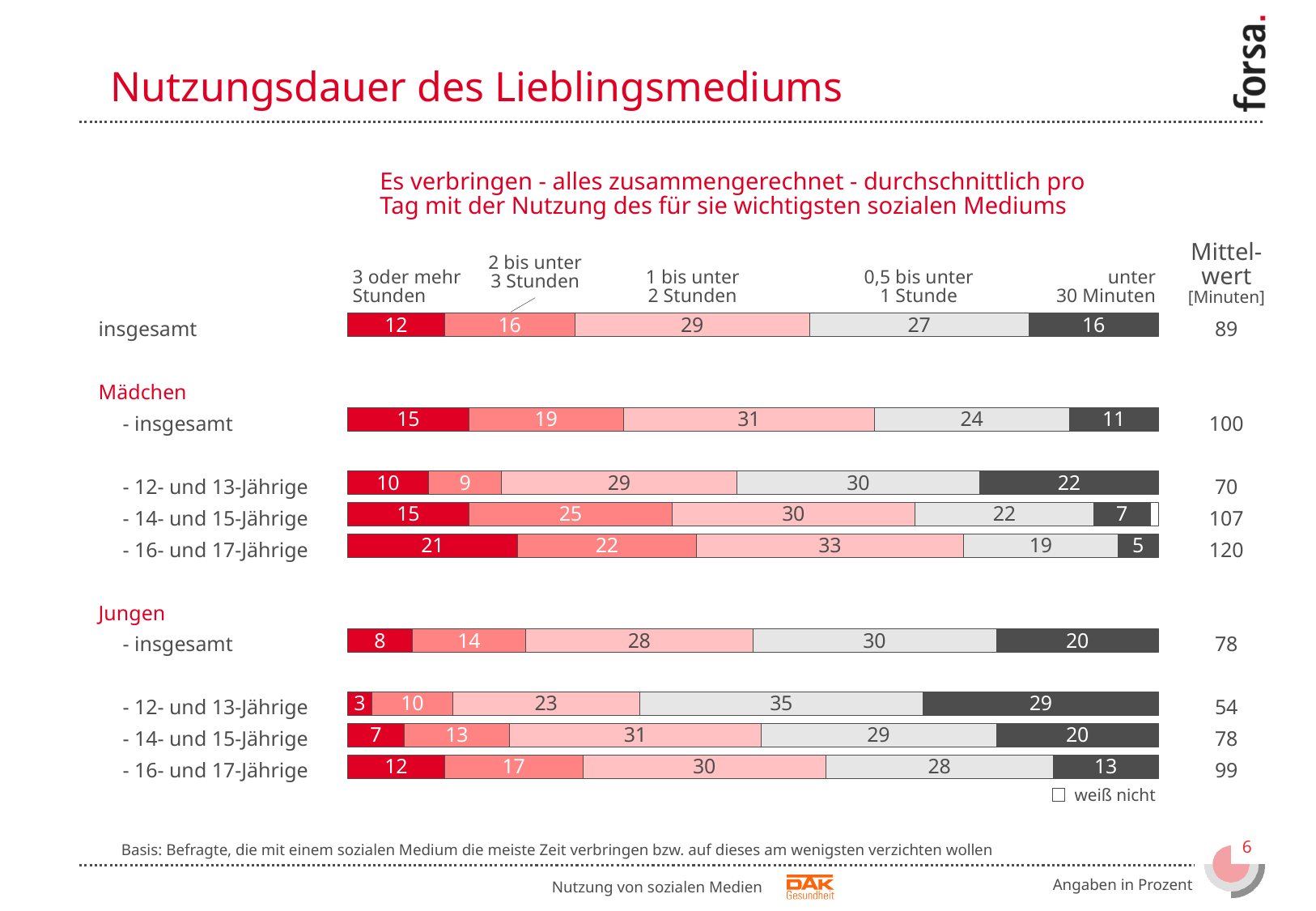
What percentage of Mädchen aged 14 und 15 use their favourite medium for 2 bis unter 3 Stunden? 25 How many duration categories (excluding weiß nicht) are shown in the stacked bars? 5 What is the combined percentage of Jungen aged 16 und 17 in the 3 oder mehr Stunden and 2 bis unter 3 Stunden categories? 29 What kind of chart is shown on the slide? Stacked bar chart What is the difference between the Mittelwert for Mädchen insgesamt and Jungen insgesamt? 22 Does the Mittelwert for Mädchen rise or fall from the 12- und 13-Jährige to the 16- und 17-Jährige? Rise Which group has the lowest Mittelwert in minutes? Jungen - 12- und 13-Jährige Which group has the highest Mittelwert in minutes? Mädchen - 16- und 17-Jährige What percentage of all respondents (insgesamt) spend 3 oder mehr Stunden per day with their most important social medium? 12 Which is larger: the share of Mädchen insgesamt or Jungen insgesamt in the 3 oder mehr Stunden category? Mädchen insgesamt What is the Mittelwert in minutes for Mädchen aged 16 und 17? 120 What percentage of Jungen aged 12 und 13 use their favourite medium for unter 30 Minuten? 29